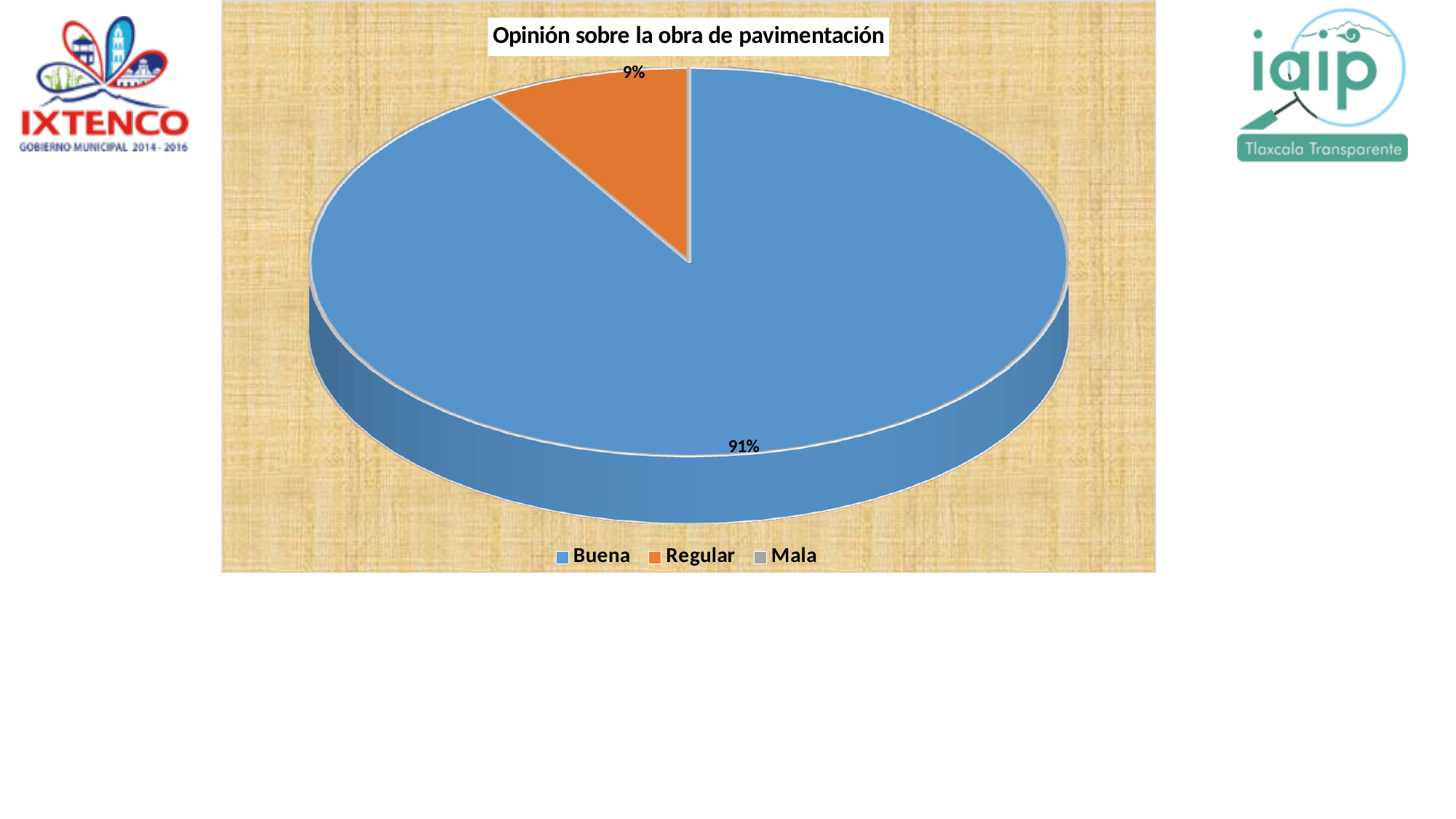
What colour is the Regular slice? orange Which is larger, the Buena slice or the Regular slice? Buena What share of the pie is labelled Buena? 91% What is the difference in percentage points between the Buena and Regular slices? 82 Is the share for Buena greater or less than 50%? greater Which legend entry has no visible slice in the pie? Mala Which category has the largest slice of the pie? Buena How many categories does the legend list? 3 What is the title of the chart? Opinión sobre la obra de pavimentación What share of the pie is labelled Regular? 9% What kind of chart is shown on the slide? pie chart